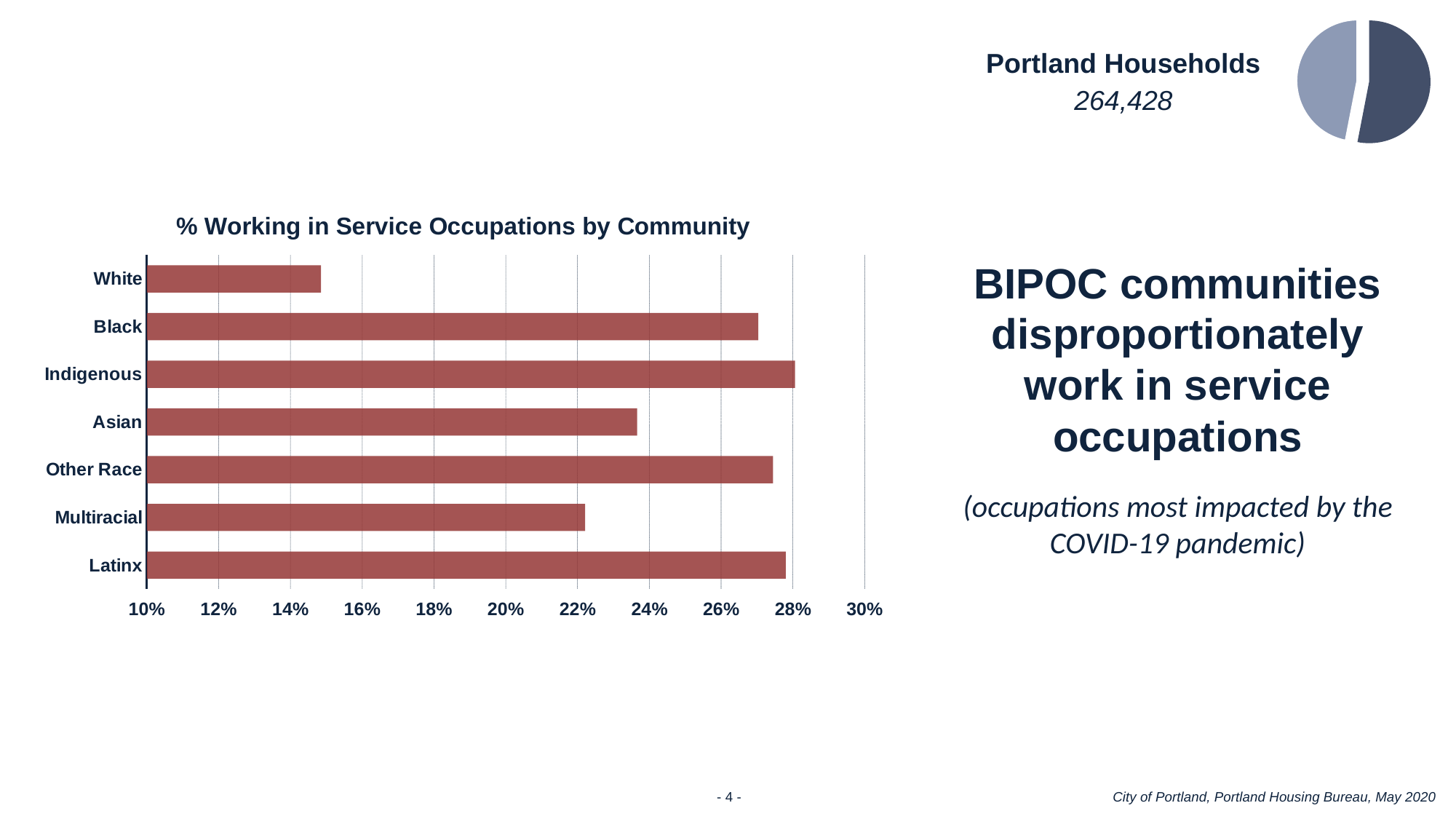
Which is larger, the value for White or the value for Black? Black What kind of chart is shown on the slide? bar chart How many communities are shown in the chart? 7 Is the value for Latinx greater or less than 26%? greater Which is larger, the value for Asian or the value for Multiracial? Asian Is the value for Multiracial greater or less than 24%? less What is the highest value shown on the x axis of the chart? 30% Is the value for Black greater or less than 26%? greater What is the title of the chart? % Working in Service Occupations by Community Which community has the lowest percentage working in service occupations? White